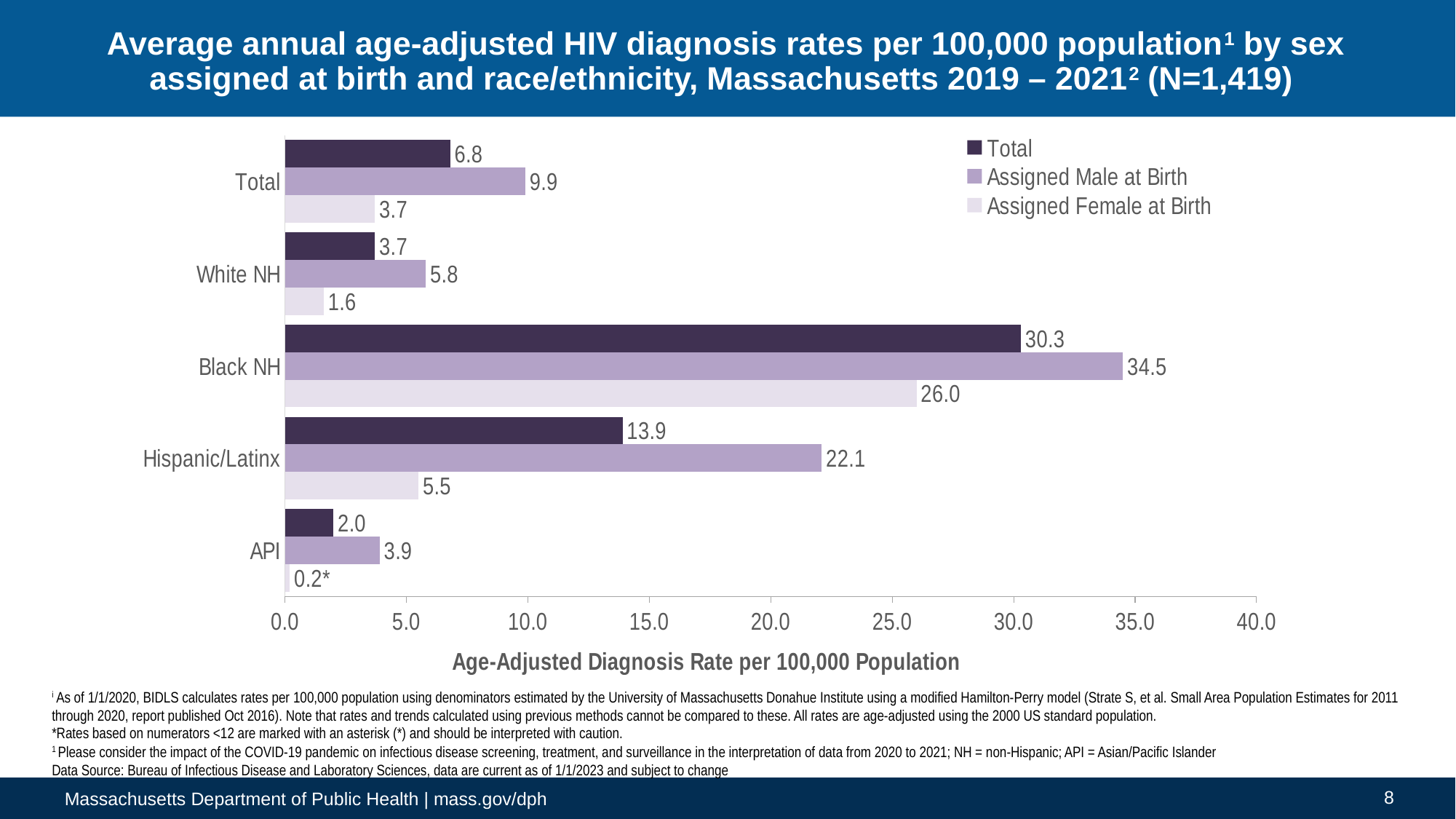
Which is larger, the Total rate for Hispanic/Latinx or the Total rate for White NH? Hispanic/Latinx What type of chart is shown on the slide? Bar chart Which race/ethnicity category has the highest Total rate? Black NH What is the Assigned Female at Birth rate for Hispanic/Latinx? 5.5 Is the Assigned Female at Birth rate for Black NH greater or less than 25.0? greater Which category has the lowest Assigned Male at Birth rate? API What is the Assigned Male at Birth rate for Black NH? 34.5 How many categories are shown on the y axis? 5 How many series does the legend list? 3 What is the Assigned Female at Birth rate for API? 0.2* What is the Total rate for White NH? 3.7 What is the difference between the Assigned Male at Birth and Assigned Female at Birth rates for Hispanic/Latinx? 16.6